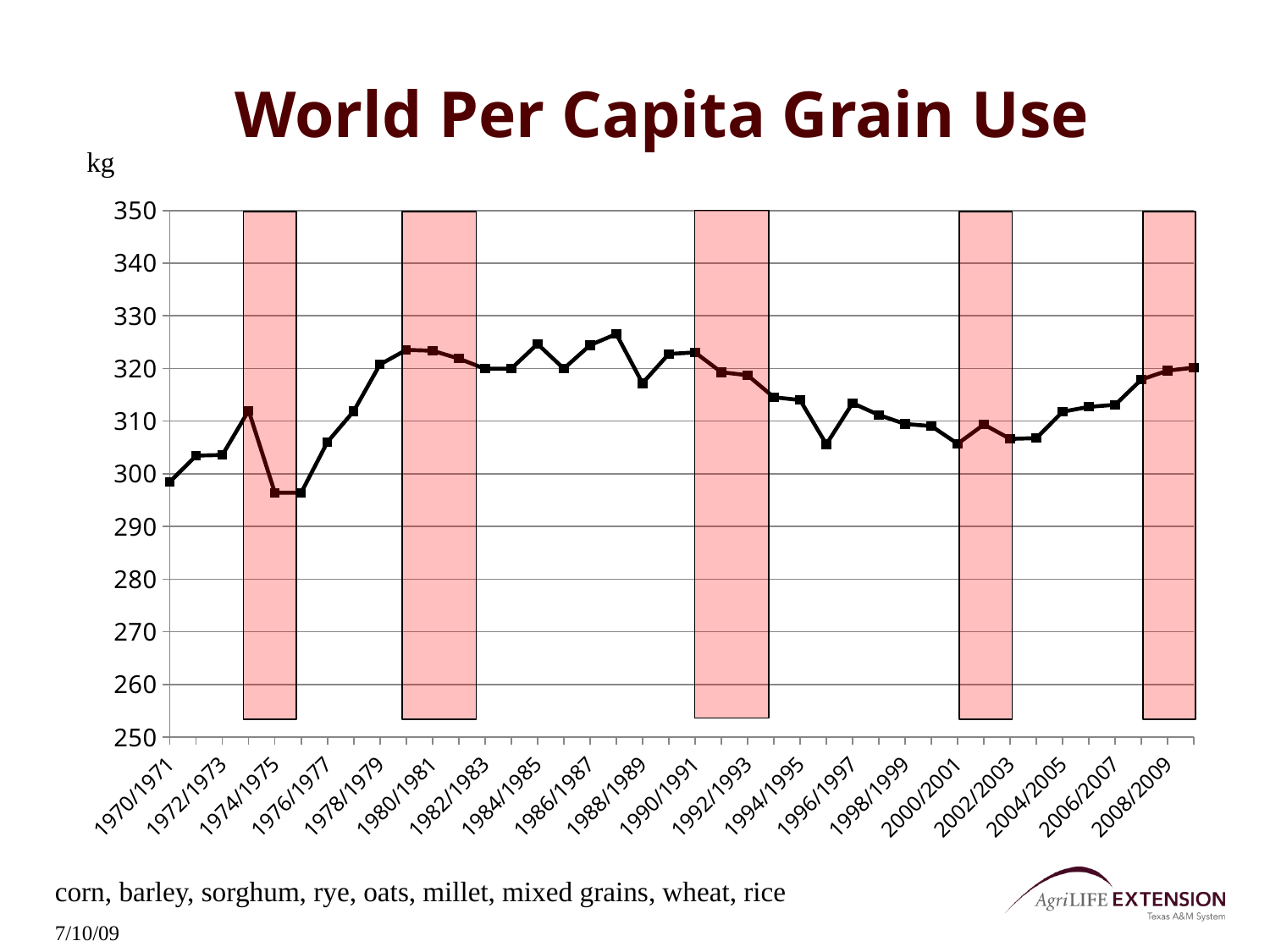
Which is larger, the value for 1990/1991 or the value for 2000/2001? 1990/1991 Is the value for 1974/1975 greater or less than 300? less Is the value for 1996/1997 greater or less than 300? greater What unit is shown on the y axis of the chart? kg Which is larger, the value for 1980/1981 or the value for 1970/1971? 1980/1981 Is the value for 1970/1971 greater or less than 300? less What kind of chart is shown on the slide? line chart Do the values rise or fall from 1974/1975 to 1980/1981? rise Do the values rise or fall from 1990/1991 to 2000/2001? fall What is the title of the chart? World Per Capita Grain Use